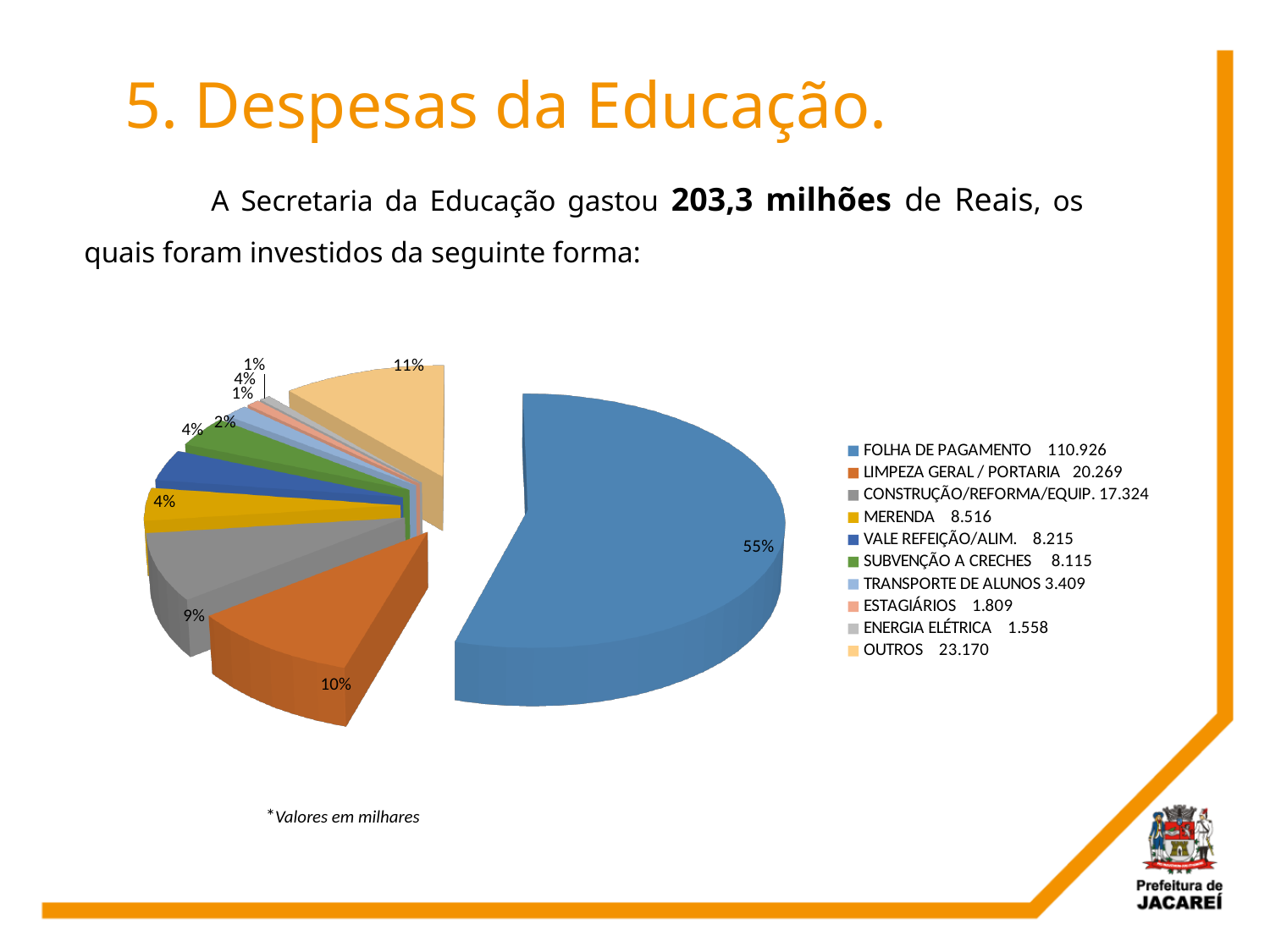
What kind of chart is shown on the slide? pie chart Which category has the largest slice of the pie? FOLHA DE PAGAMENTO What is the difference between the values for FOLHA DE PAGAMENTO and LIMPEZA GERAL / PORTARIA? 90.657 What value is shown in the legend for FOLHA DE PAGAMENTO? 110.926 What colour is the FOLHA DE PAGAMENTO slice? blue What share of the pie does FOLHA DE PAGAMENTO represent? 55% Which category has the smallest value in the legend? ENERGIA ELÉTRICA What value is shown in the legend for OUTROS? 23.170 How many categories does the pie chart's legend list? 10 Which has the larger value, MERENDA or VALE REFEIÇÃO/ALIM.? MERENDA What value is shown in the legend for TRANSPORTE DE ALUNOS? 3.409 What share of the pie does OUTROS represent? 11%